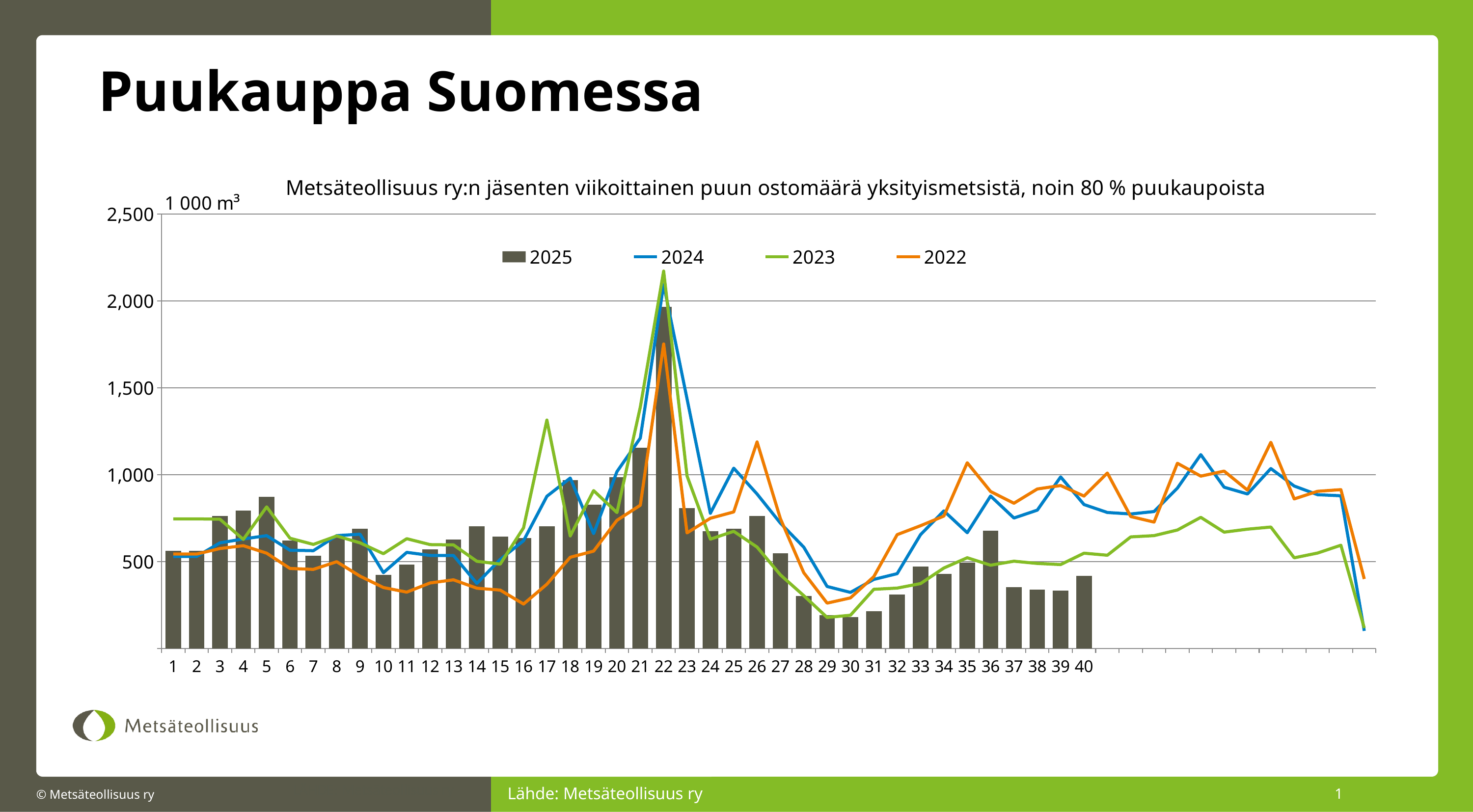
What kind of chart is shown on the slide? A combined bar and line chart Do the 2025 bars rise or fall from week 22 to week 30? Fall How many weeks have a bar plotted for the 2025 series? 40 At week 22, which series reaches a higher value: 2023 or 2022? 2023 Is the 2024 value for the last week (week 52) greater or less than 500? less Is the 2025 value for week 22 greater or less than 1,500? greater Which is larger for 2025: the bar for week 36 or the bar for week 37? Week 36 Is the 2025 value for week 29 greater or less than 500? less How many series does the legend list? 4 What unit is shown on the vertical axis of the chart? 1 000 m³ In which week is the 2025 bar the highest? 22